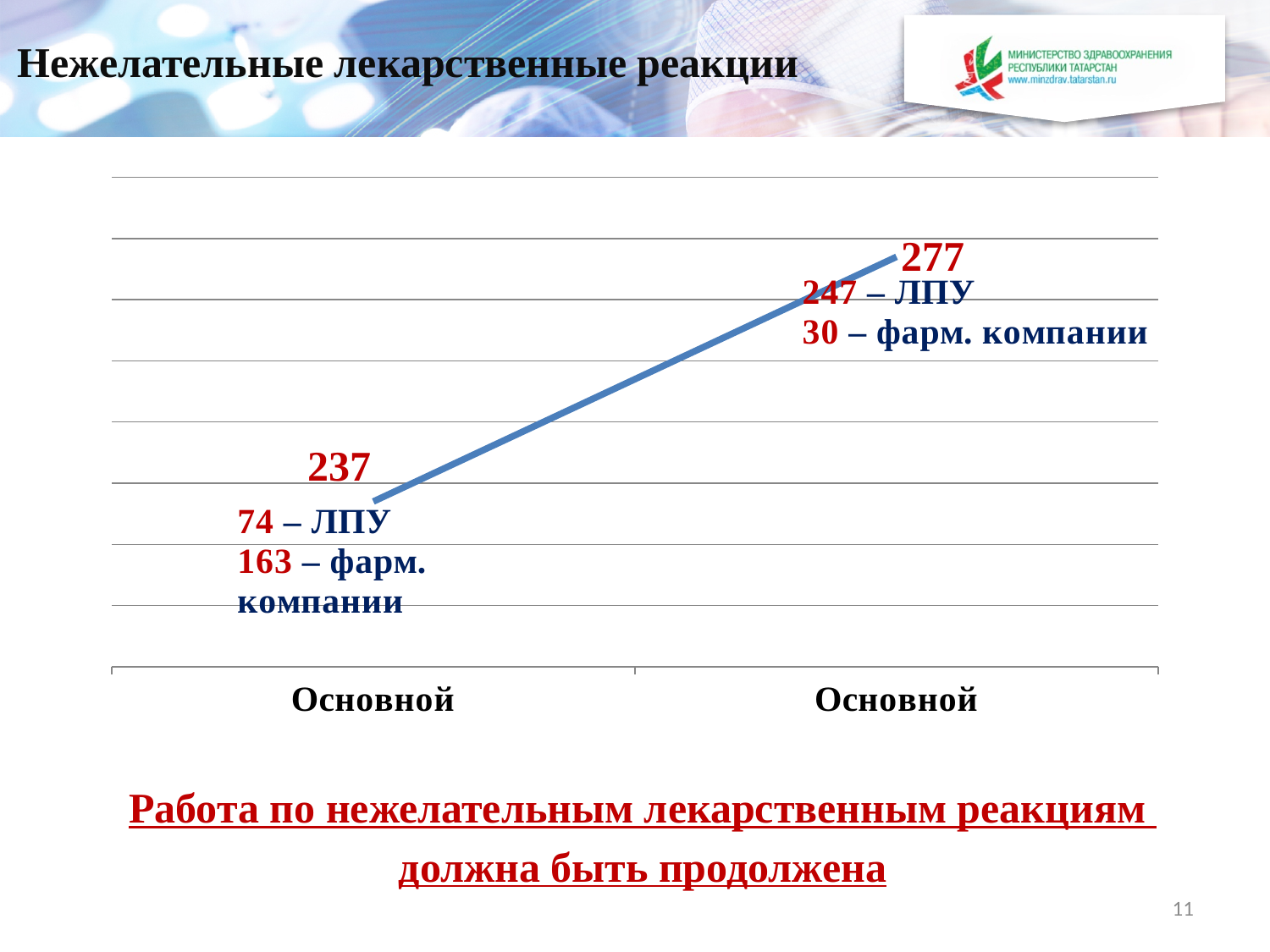
What is the title of the slide containing the chart? Нежелательные лекарственные реакции Which point has the higher value, the left one or the right one? the right one Do the values rise or fall from left to right along the x axis? rise What is the difference between the right point (277) and the left point (237)? 40 What is the highest value plotted on the chart? 277 According to the annotation next to the 237 point, how many reactions came from ЛПУ? 74 According to the annotation next to the 277 point, how many reactions came from фарм. компании? 30 What is the lowest value plotted on the chart? 237 How many data points are plotted on the line? 2 What kind of chart is shown on the slide? line chart What is the value of the first (left) point on the line? 237 What is the value of the second (right) point on the line? 277